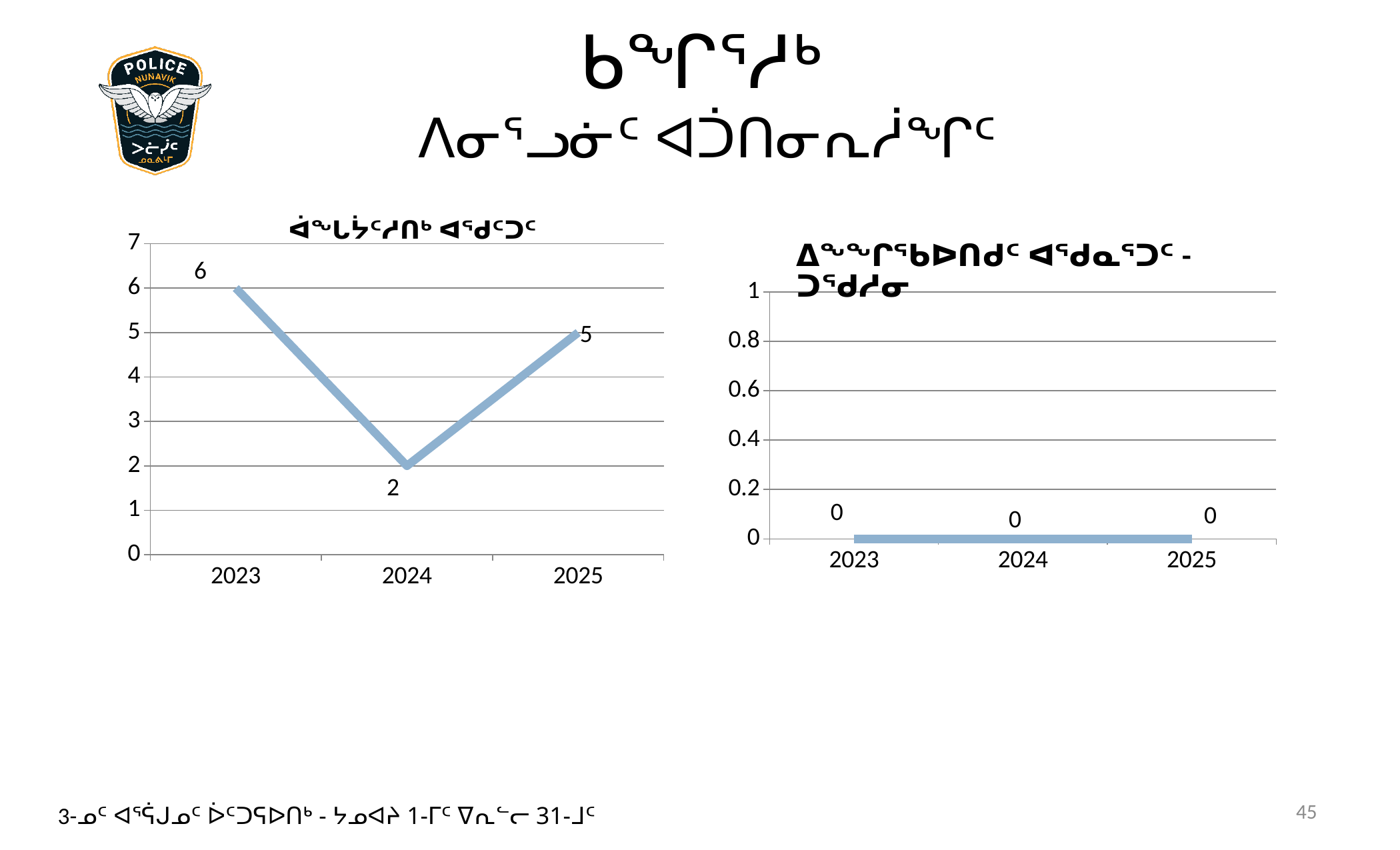
In the left chart, which is larger, the value for 2025 or the value for 2024? 2025 In the left chart, what is the difference between the values for 2023 and 2024? 4 How many years are plotted on the left chart? 3 What kind of chart is the left chart? line chart In the left chart, what is the value for 2025? 5 In the left chart, does the value rise or fall from 2024 to 2025? rise In the left chart, which year has the highest value? 2023 In the right chart, what is the value for 2024? 0 In the right chart, what is the total of the values for 2023, 2024 and 2025? 0 In the left chart, what is the value for 2023? 6 In the left chart, what is the value for 2024? 2 In the left chart, which year has the lowest value? 2024